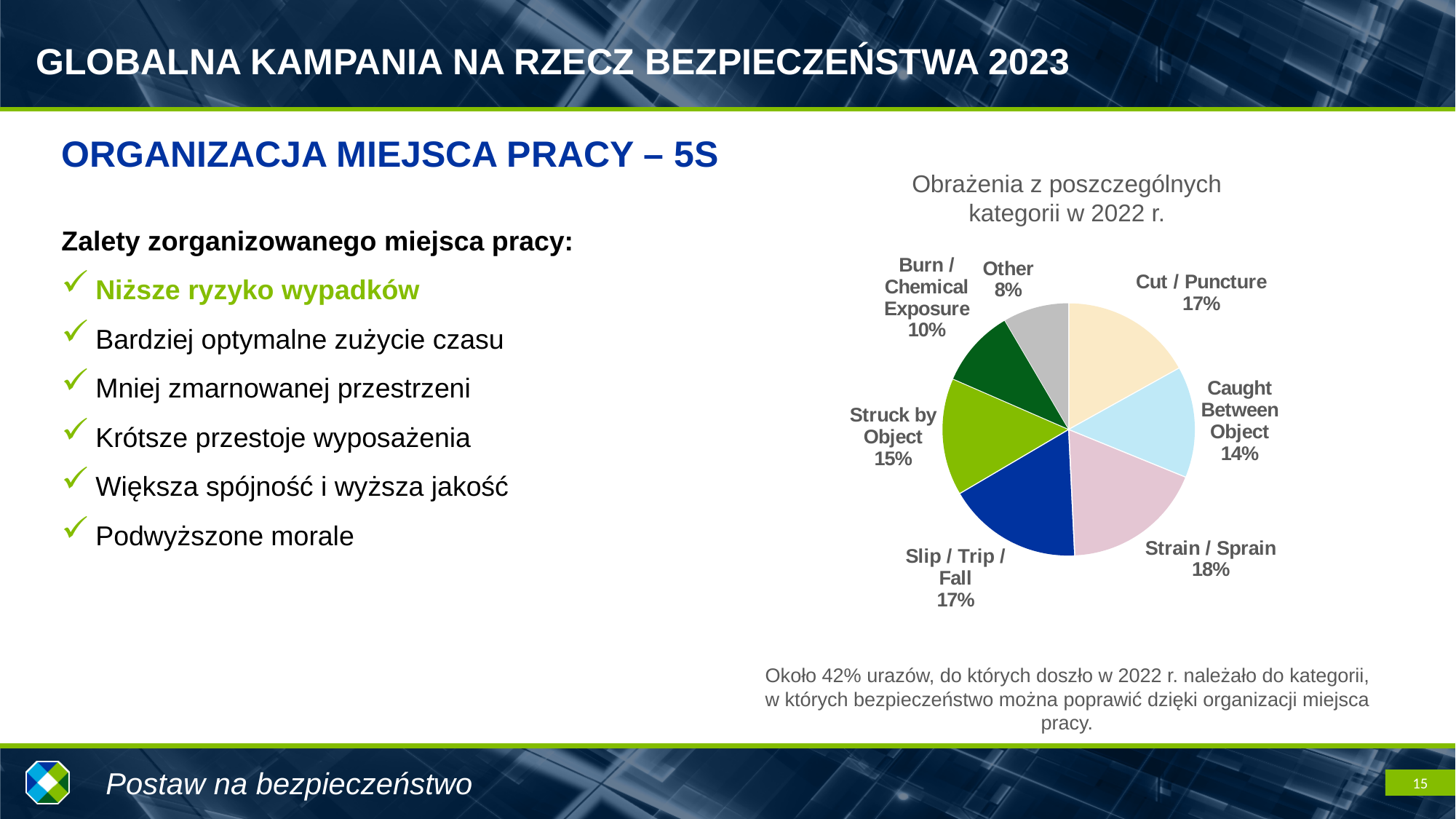
Which injury category has the smallest share of the pie? Other Which injury category has the largest share of the pie? Strain / Sprain What is the combined share of Cut / Puncture and Slip / Trip / Fall? 34% What type of chart is shown on the slide? Pie chart What share of injuries does the Strain / Sprain slice represent? 18% What percentage is shown for Burn / Chemical Exposure? 10% What percentage is shown for Caught Between Object? 14% What is the title of the chart? Obrażenia z poszczególnych kategorii w 2022 r. Which is larger, the share for Struck by Object or the share for Caught Between Object? Struck by Object What percentage is shown for Struck by Object? 15% How many categories are shown in the pie chart? 7 What is the difference in percentage points between Strain / Sprain and Other? 10